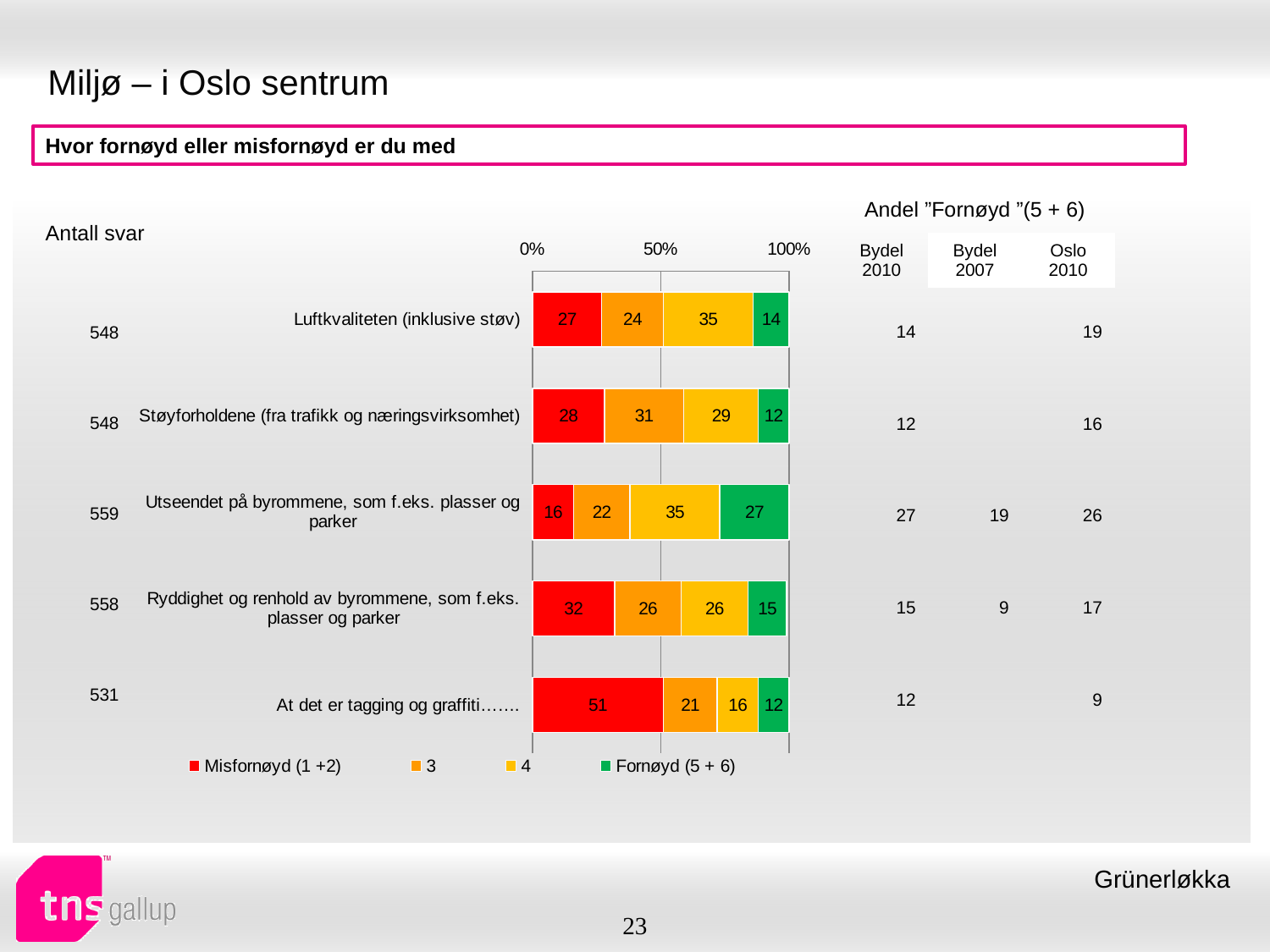
What is the value of the "4" segment for "Støyforholdene (fra trafikk og næringsvirksomhet)"? 29 What is the total of the stacked bar for "Luftkvaliteten (inklusive støv)"? 100 Which has the larger Fornøyd (5 + 6) value: "Utseendet på byrommene" or "Ryddighet og renhold av byrommene"? Utseendet på byrommene How many series does the legend list? 4 Which category has the lowest Misfornøyd (1 +2) value? Utseendet på byrommene, som f.eks. plasser og parker What kind of chart is shown on the slide? Stacked bar chart How many categories are shown in the bar chart? 5 What is the value of the Fornøyd (5 + 6) segment for "Utseendet på byrommene, som f.eks. plasser og parker"? 27 How much larger is the Misfornøyd (1 +2) value for "At det er tagging og graffiti" than for "Luftkvaliteten (inklusive støv)"? 24 Which category has the highest Misfornøyd (1 +2) value? At det er tagging og graffiti What is the value of the Misfornøyd (1 +2) segment for "At det er tagging og graffiti"? 51 What colour represents the Fornøyd (5 + 6) series in the chart? Green